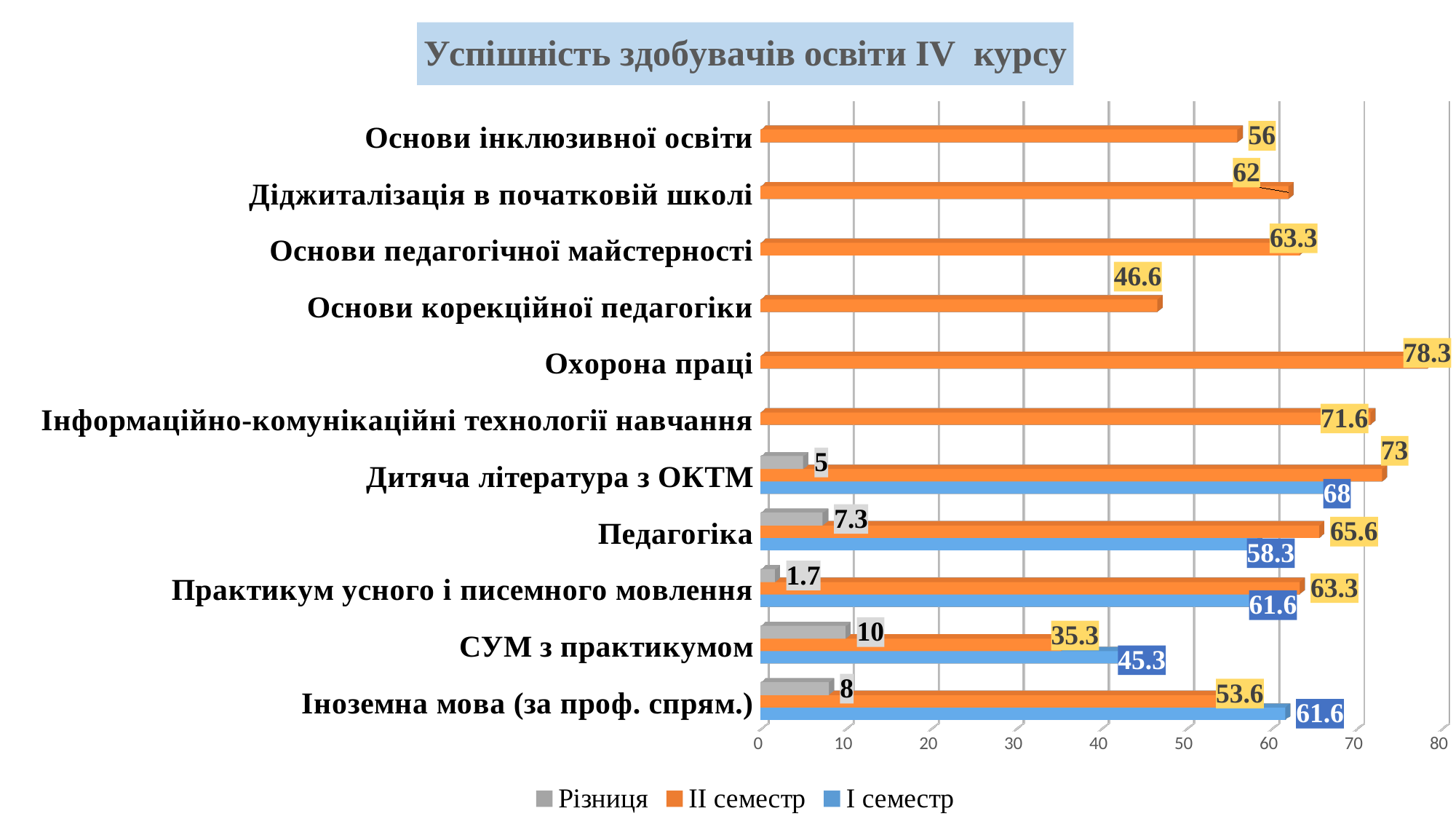
What type of chart is shown on the slide? bar chart For СУМ з практикумом, which is larger: the I семестр value or the II семестр value? I семестр Which category has the highest I семестр value? Дитяча література з ОКТМ How many series does the legend list? 3 What is the Різниця value for СУМ з практикумом? 10 What is the I семестр value for Педагогіка? 58.3 Is the II семестр value for Основи корекційної педагогіки greater or less than 50? less What is the difference between the II семестр and I семестр values for Дитяча література з ОКТМ? 5 Which category has the highest II семестр value? Охорона праці What is the II семестр value for Охорона праці? 78.3 How many categories are shown on the chart? 11 Which category has the lowest II семестр value? СУМ з практикумом